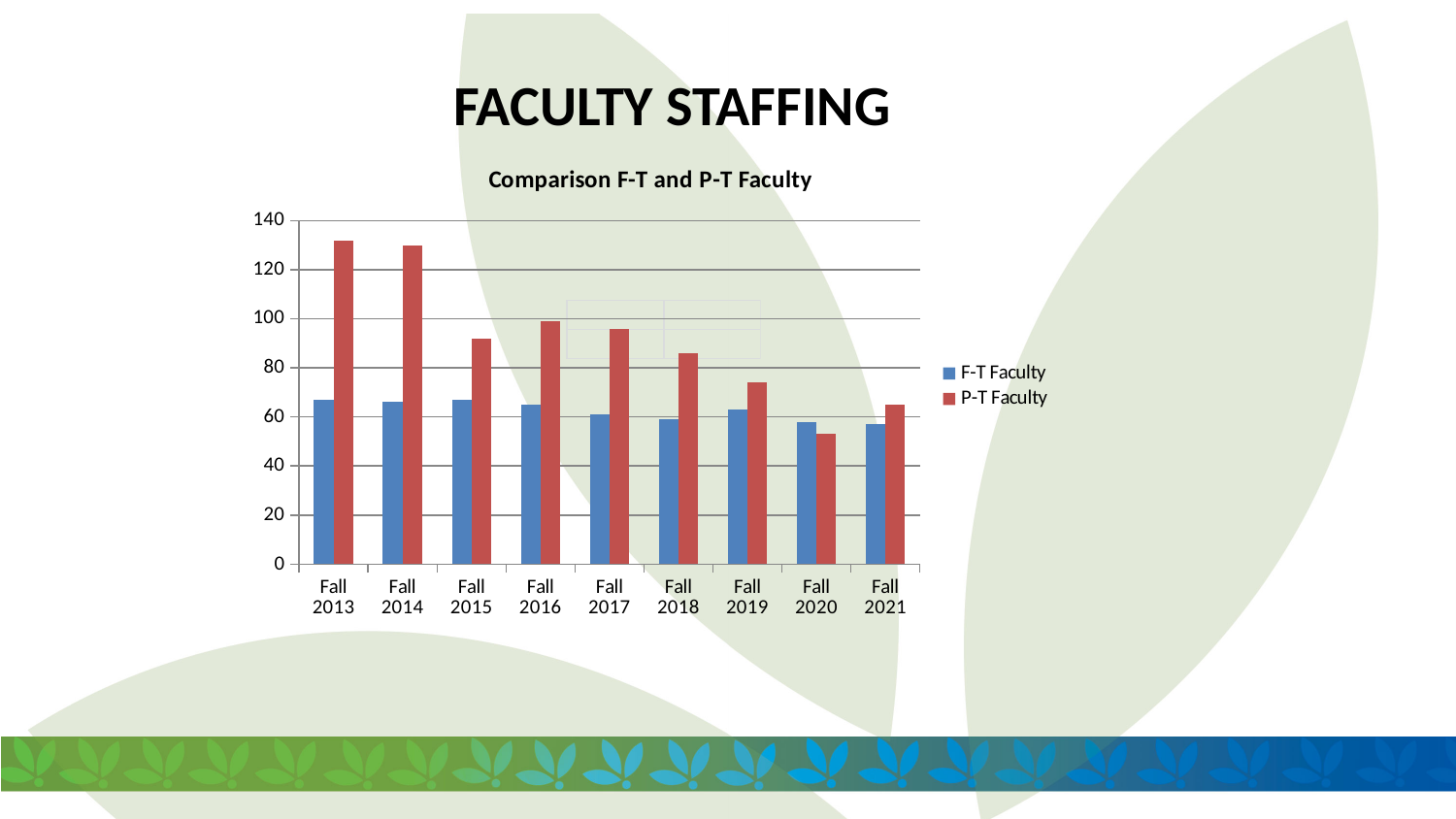
How many Fall terms are shown on the x axis? 9 In Fall 2013, which is larger: F-T Faculty or P-T Faculty? P-T Faculty Is the P-T Faculty value for Fall 2019 greater or less than 80? less What is the title of the chart? Comparison F-T and P-T Faculty How many series does the legend list? 2 In Fall 2020, which is larger: F-T Faculty or P-T Faculty? F-T Faculty Which Fall term has the lowest P-T Faculty value? Fall 2020 Is the P-T Faculty value for Fall 2020 greater or less than 60? less What kind of chart is shown on the slide? Bar chart Is the F-T Faculty value for Fall 2013 greater or less than 60? greater Does the P-T Faculty value generally rise or fall from Fall 2013 to Fall 2020? Fall